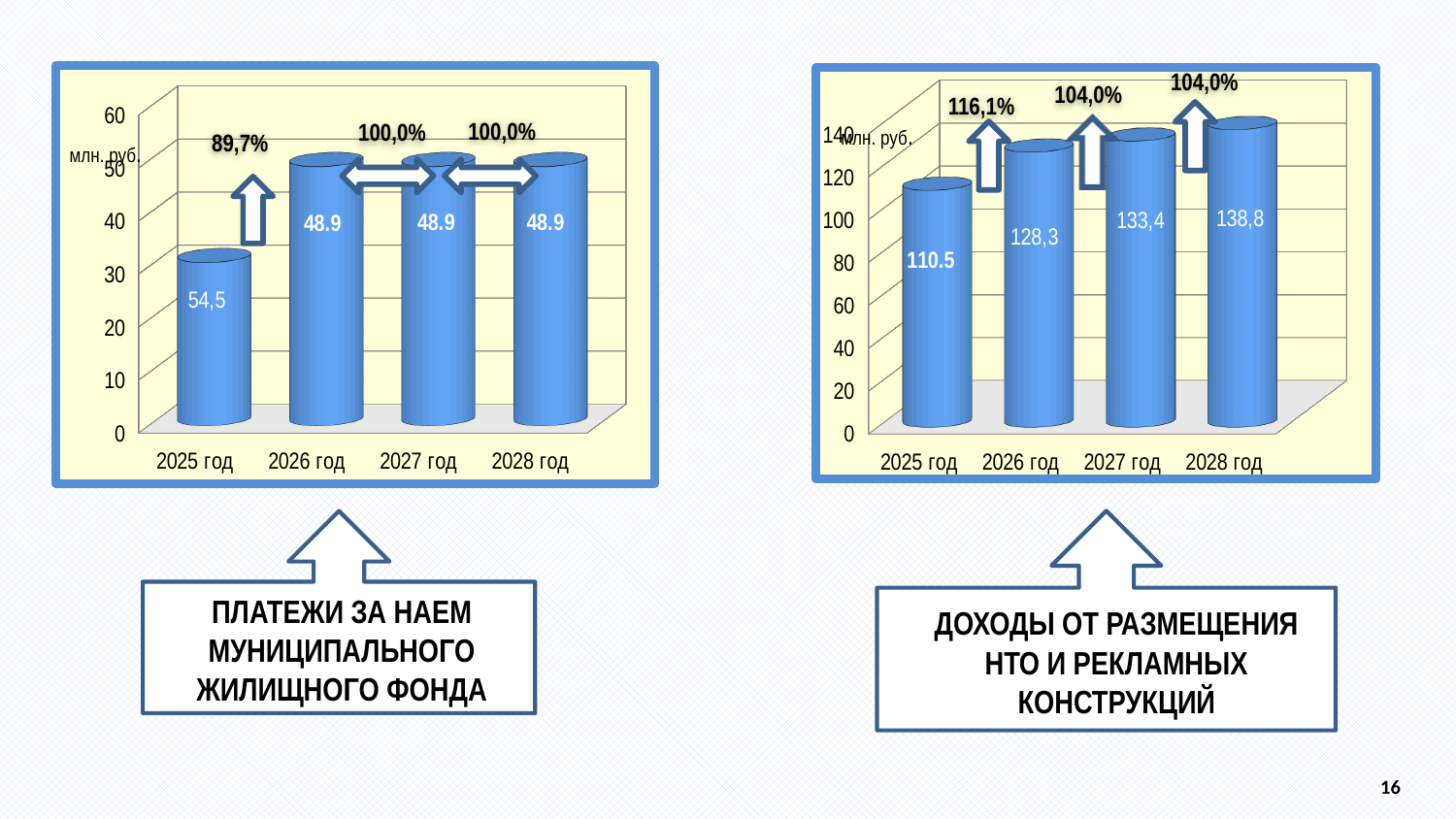
How many years are shown on the left chart (Платежи за наем муниципального жилищного фонда)? 4 On the right chart (Доходы от размещения НТО и рекламных конструкций), do the values rise or fall from 2025 год to 2028 год? rise On the right chart (Доходы от размещения НТО и рекламных конструкций), what percentage is shown above the 2026 год bar? 116,1% On the left chart (Платежи за наем муниципального жилищного фонда), what is the value for 2027 год? 48.9 On the right chart (Доходы от размещения НТО и рекламных конструкций), what is the value for 2025 год? 110.5 On the right chart (Доходы от размещения НТО и рекламных конструкций), what is the value for 2028 год? 138,8 On the right chart (Доходы от размещения НТО и рекламных конструкций), which year has the highest value? 2028 год On the right chart (Доходы от размещения НТО и рекламных конструкций), what is the difference between the values for 2027 год and 2026 год? 5,1 What kind of chart is the right chart (Доходы от размещения НТО и рекламных конструкций)? bar chart On the left chart (Платежи за наем муниципального жилищного фонда), what is the value for 2025 год? 54,5 On the right chart (Доходы от размещения НТО и рекламных конструкций), which is larger, the value for 2026 год or 2027 год? 2027 год On the right chart (Доходы от размещения НТО и рекламных конструкций), which year has the lowest value? 2025 год